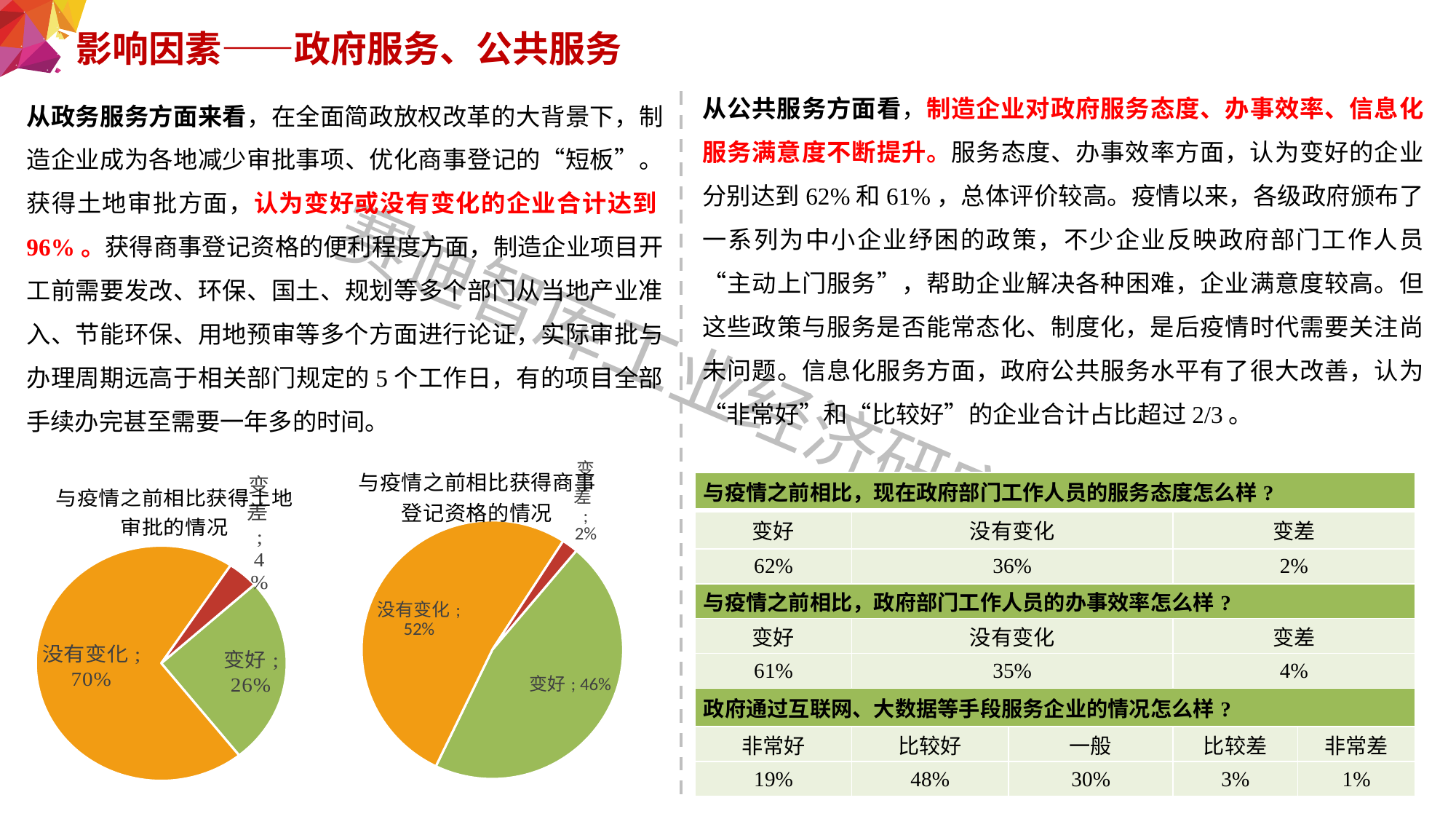
In the pie chart titled 与疫情之前相比获得土地审批的情况, what is the difference between the shares for 没有变化 and 变好? 44% In the pie chart titled 与疫情之前相比获得土地审批的情况, what is the share for 没有变化? 70% How many slices does the pie chart titled 与疫情之前相比获得土地审批的情况 have? 3 What type of chart is the chart titled 与疫情之前相比获得商事登记资格的情况? Pie chart In the pie chart titled 与疫情之前相比获得商事登记资格的情况, which is larger, the share for 没有变化 or the share for 变好? 没有变化 In the pie chart titled 与疫情之前相比获得土地审批的情况, what is the share for 变差? 4% In the pie chart titled 与疫情之前相比获得商事登记资格的情况, what is the share for 变好? 46% In the pie chart titled 与疫情之前相比获得土地审批的情况, which category has the largest slice? 没有变化 In the pie chart titled 与疫情之前相比获得商事登记资格的情况, what is the share for 没有变化? 52% In the pie chart titled 与疫情之前相比获得土地审批的情况, what is the share for 变好? 26% In the pie chart titled 与疫情之前相比获得商事登记资格的情况, which category has the smallest slice? 变差 In the pie chart titled 与疫情之前相比获得商事登记资格的情况, what is the share for 变差? 2%